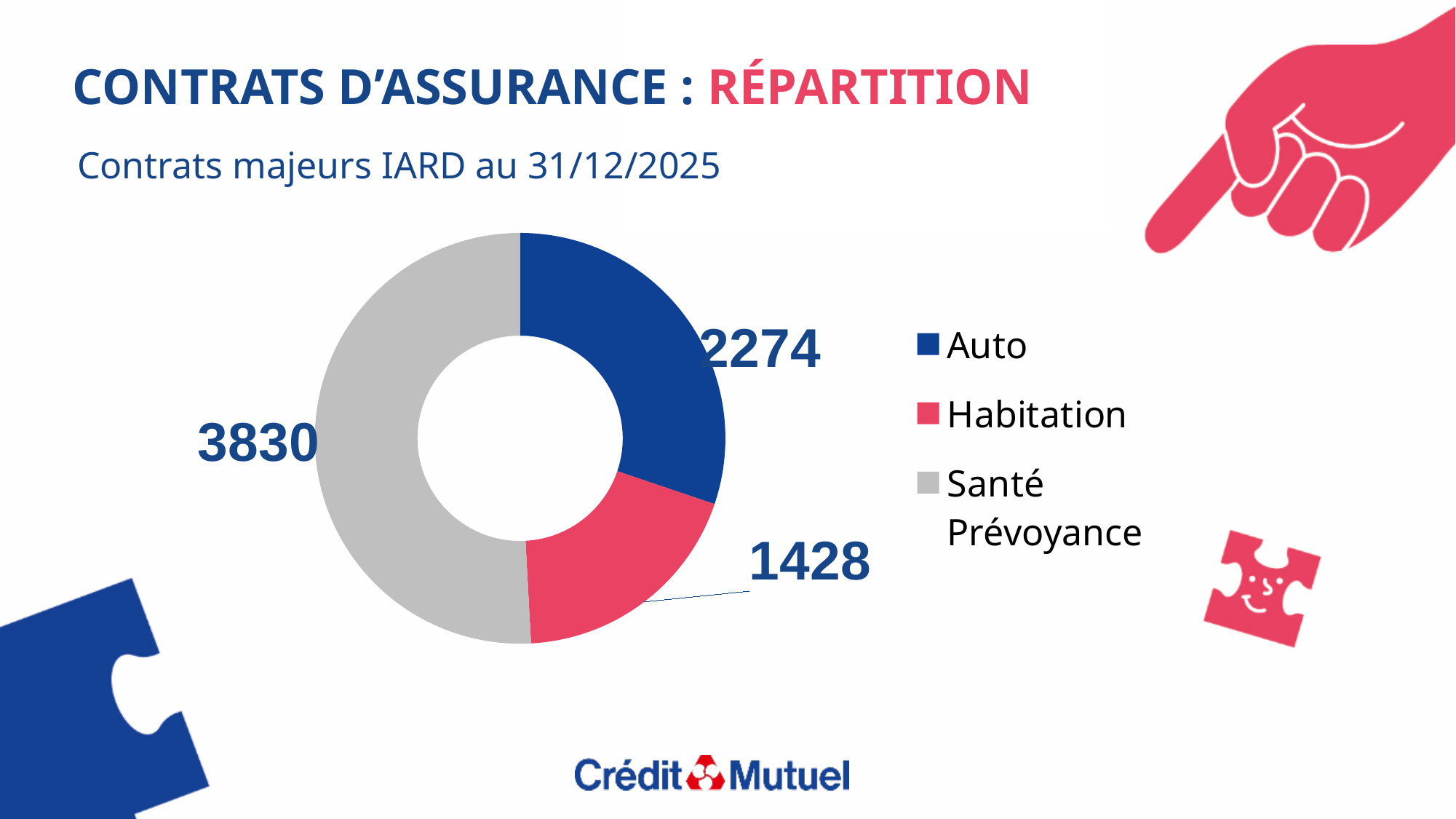
Which is larger, the value for Auto or the value for Habitation? Auto What is the value shown for Habitation? 1428 Which category has the highest value? Santé Prévoyance What is the difference between the values for Santé Prévoyance and Auto? 1556 What is the value shown for Santé Prévoyance? 3830 Which category has the lowest value? Habitation What is the difference between the values for Auto and Habitation? 846 Which colour represents Santé Prévoyance in the chart? Grey What kind of chart is shown on the slide? Donut (pie) chart How many categories does the chart show? 3 What is the value shown for Auto? 2274 What is the total of all three values in the chart? 7532